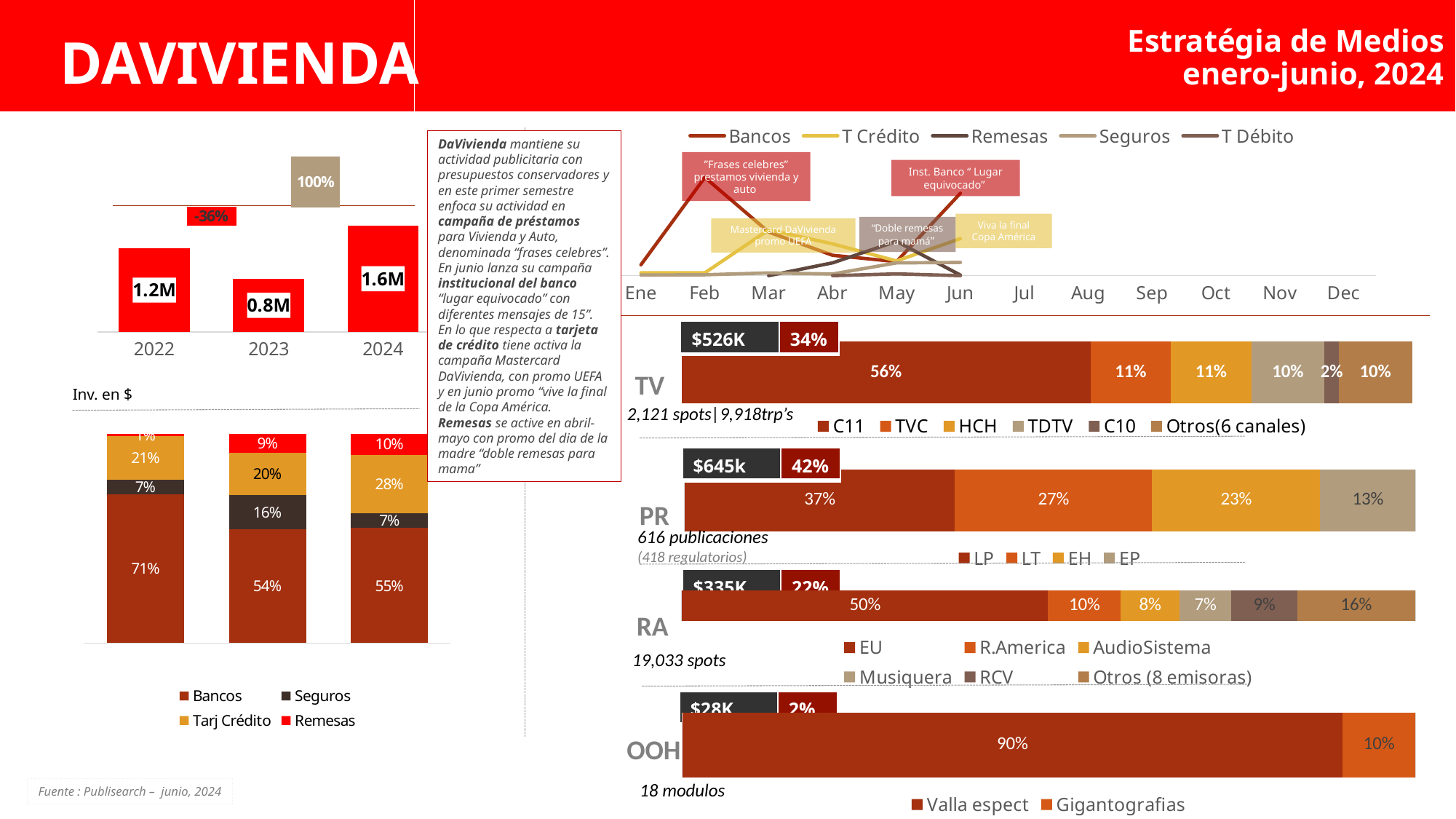
In the bar chart of investment by year on the left, what percentage change is shown above the 2024 bar? 100% In the line chart at the top right, how many series does the legend list? 5 In the stacked bar chart 'Inv. en $' on the left, what share does Tarj Crédito have in 2024? 28% In the OOH bar on the right, which is larger, Valla espect or Gigantografias? Valla espect In the bar chart of investment by year on the left, what is the value for 2024? 1.6M In the PR bar on the right, what is the difference between the LP share and the EP share? 24% In the TV bar on the right, what share does C11 have? 56% What kind of chart is the 'Inv. en $' chart on the left? Stacked bar chart In the stacked bar chart 'Inv. en $' on the left, what share does Bancos have in 2022? 71% In the stacked bar chart 'Inv. en $' on the left, how many series does the legend list? 4 In the RA bar on the right, which station has the highest share? EU In the bar chart of investment by year on the left, which year has the lowest value? 2023